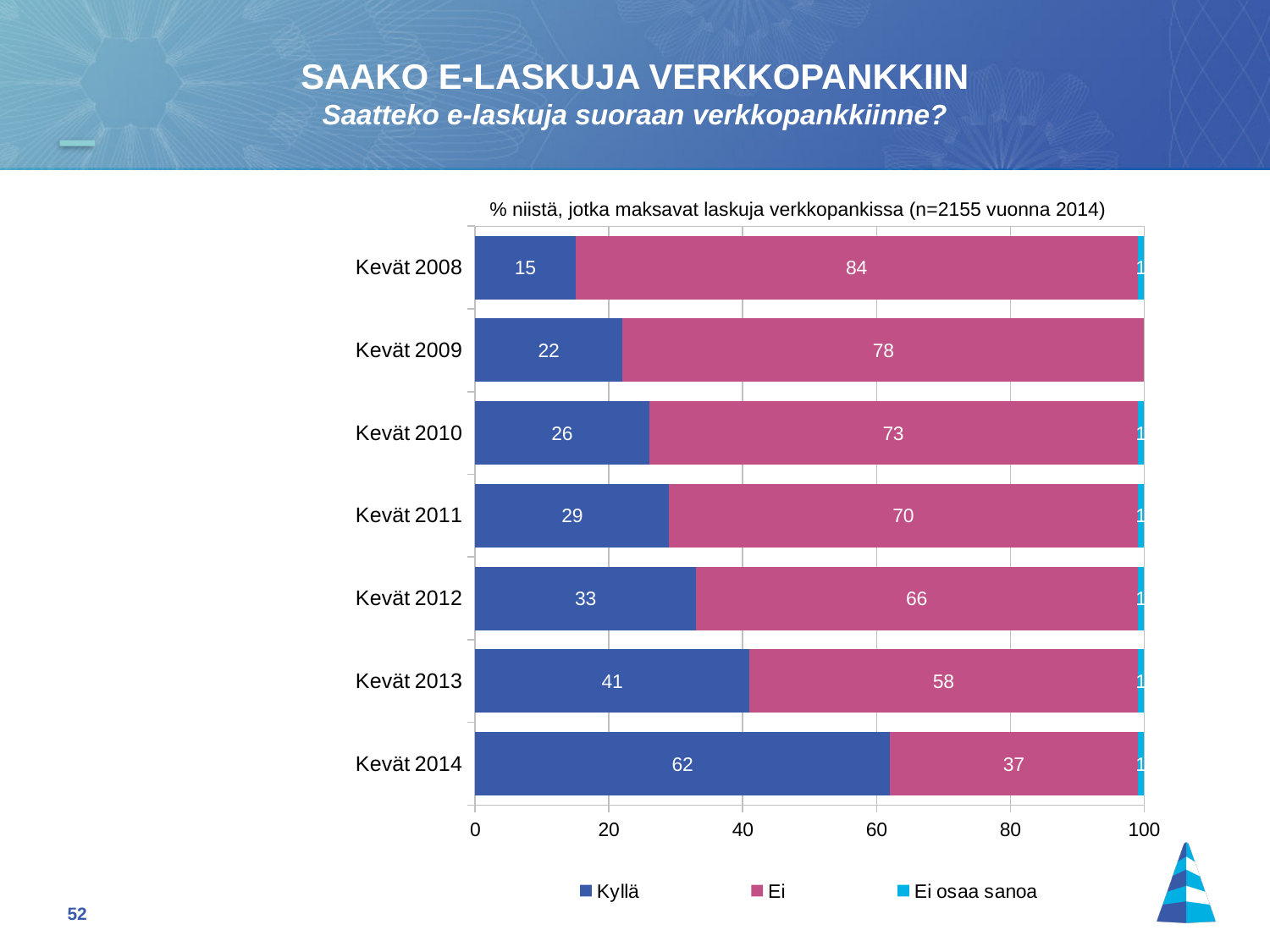
How many series does the legend list? 3 What is the Kyllä value for Kevät 2011? 29 What is the Kyllä value for Kevät 2014? 62 What kind of chart is shown on the slide? Stacked bar chart What is the total of the Kevät 2013 bar (Kyllä + Ei + Ei osaa sanoa)? 100 What is the Ei value for Kevät 2008? 84 Which is larger, the Ei value for Kevät 2012 or the Ei value for Kevät 2013? Kevät 2012 Do the Kyllä values rise or fall from Kevät 2008 to Kevät 2014? Rise Which year has the highest Kyllä value? Kevät 2014 How many years (categories) are shown on the chart? 7 What is the difference between the Kyllä values for Kevät 2014 and Kevät 2013? 21 Which year has the lowest Ei value? Kevät 2014